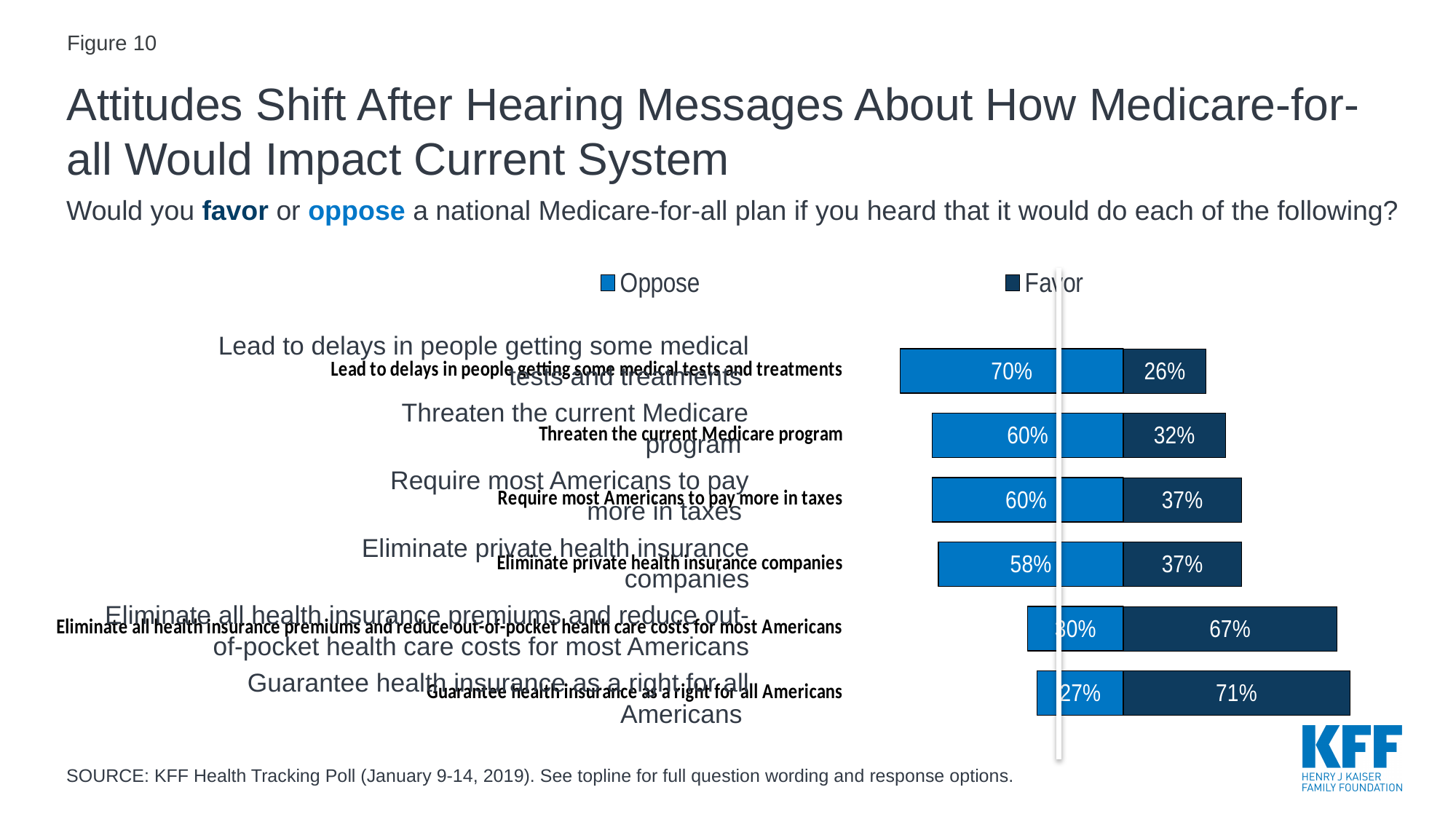
Which message has the lowest Favor percentage? Lead to delays in people getting some medical tests and treatments What is the Favor value for 'Threaten the current Medicare program'? 32% What percentage favor a Medicare-for-all plan if it would guarantee health insurance as a right for all Americans? 71% What percentage oppose a Medicare-for-all plan if it would lead to delays in people getting some medical tests and treatments? 70% What kind of chart is shown on the slide? Bar chart What is the difference between the Oppose and Favor percentages for 'Lead to delays in people getting some medical tests and treatments'? 44 percentage points Which message has the highest Favor percentage? Guarantee health insurance as a right for all Americans For 'Require most Americans to pay more in taxes', which is larger, the Oppose or the Favor percentage? Oppose What is the Oppose value for 'Eliminate private health insurance companies'? 58% Which series is shown in the darker blue colour? Favor How many messages (categories) are shown in the chart? 6 How many series does the legend list? 2